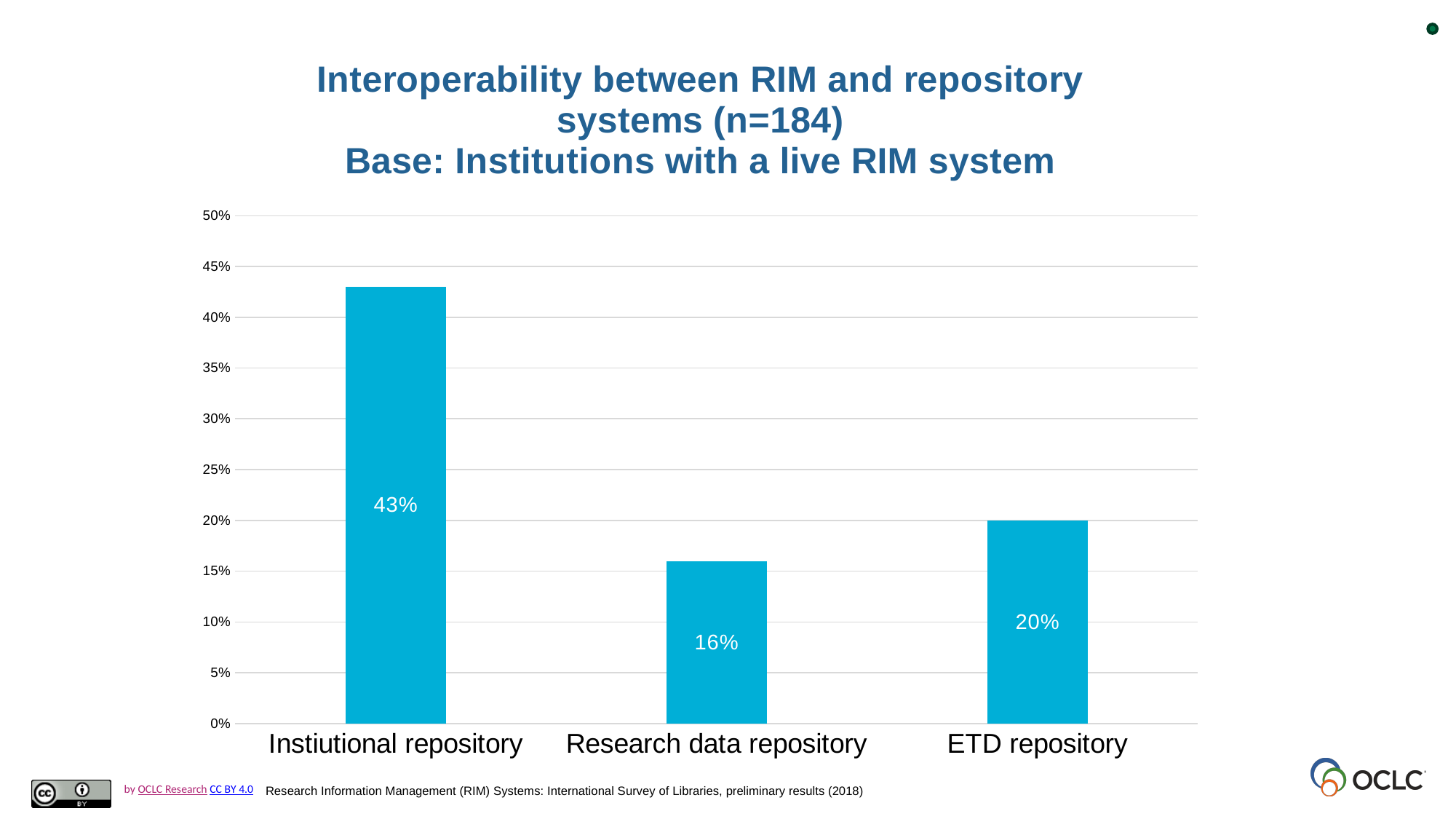
Is the value for Institutional repository greater or less than 40%? greater What kind of chart is shown on the slide? Bar chart What is the sample size (n) given in the chart title? 184 Which is larger, the value for ETD repository or the value for Research data repository? ETD repository What is the difference between the values for Institutional repository and ETD repository? 23% What is the difference between the values for ETD repository and Research data repository? 4% Which category has the highest value? Institutional repository Which category has the lowest value? Research data repository What is the value for Research data repository? 16% How many categories are shown on the chart? 3 What is the value for Institutional repository? 43% What is the value for ETD repository? 20%